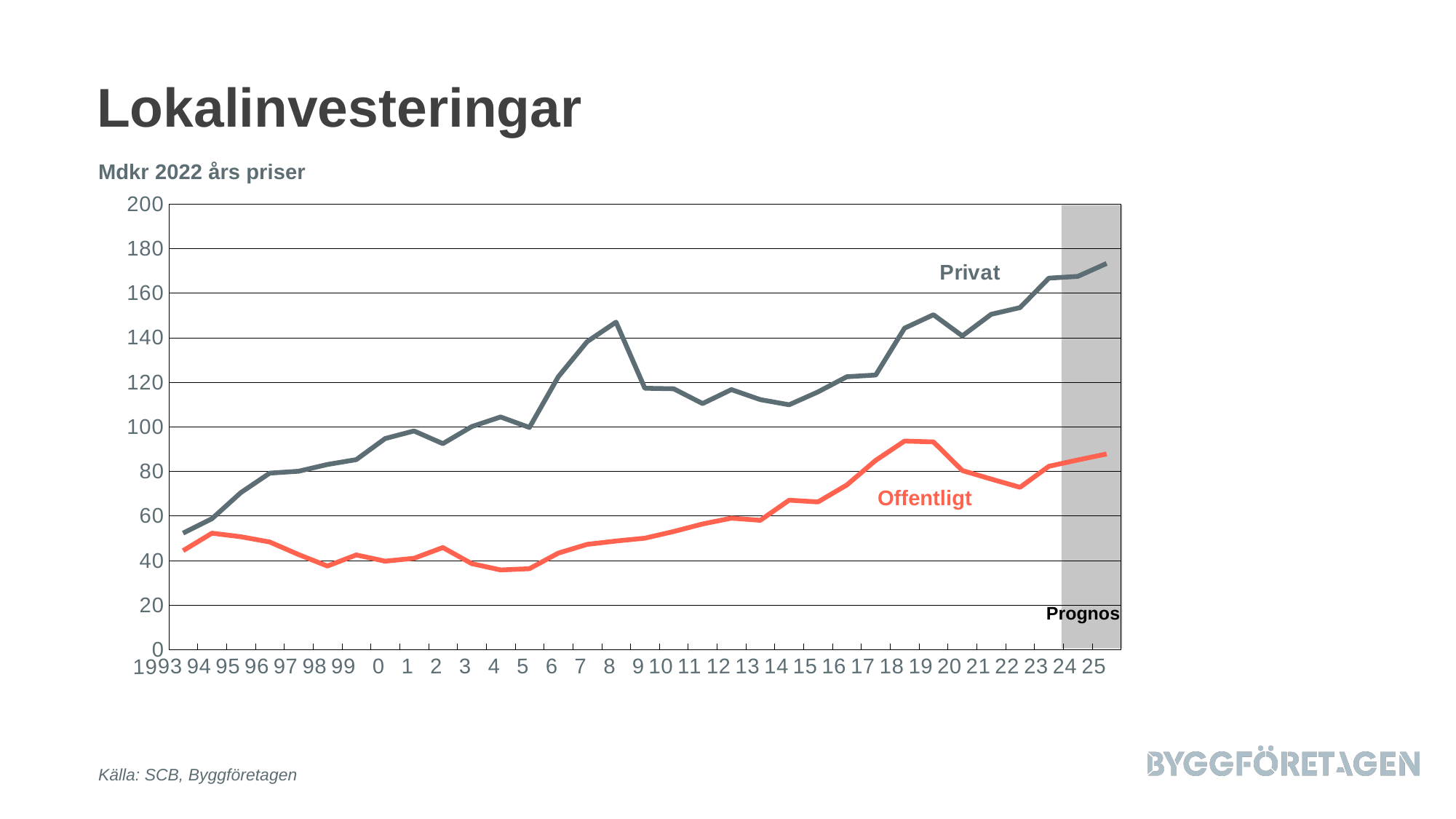
Is the value for Offentligt in 2019 greater or less than 80? greater Is the value for Privat in 1993 greater or less than 60? less What are the names of the two series in the chart? Privat and Offentligt How many series are plotted in the chart? 2 Is the value for Privat in 2008 greater or less than 140? greater What unit is given in the chart's subtitle? Mdkr 2022 års priser What kind of chart is shown on the slide? line chart In which year does the Privat series reach its highest value? 2025 Which series has the higher value in 2010, Privat or Offentligt? Privat In which year does the Privat series have its lowest value? 1993 Does the Privat series rise or fall between 2008 and 2009? fall